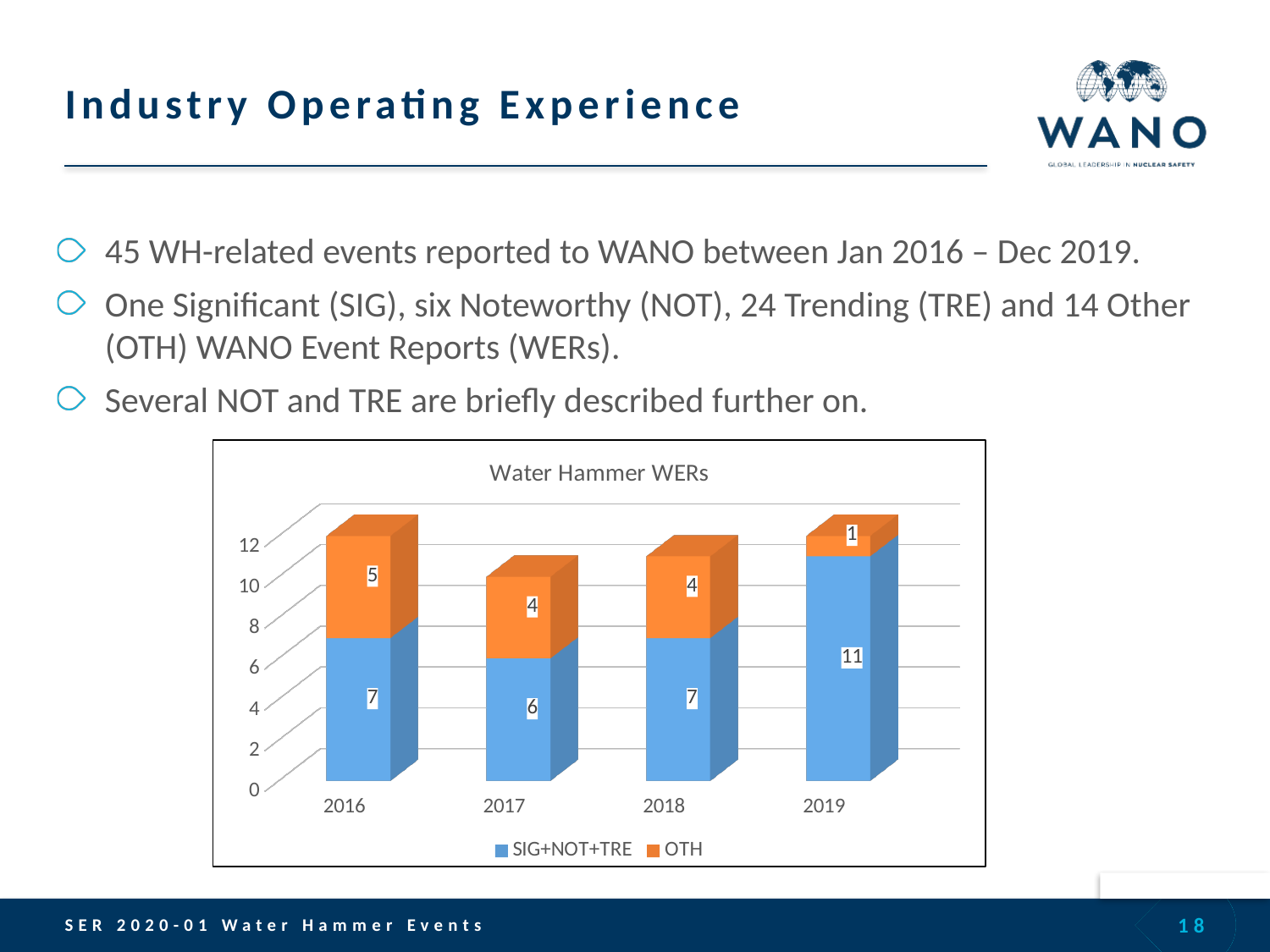
How many years are shown on the x axis? 4 What is the OTH value for 2019? 1 What is the SIG+NOT+TRE value for 2017? 6 Which year has the highest SIG+NOT+TRE value? 2019 How many series does the legend list? 2 Is the OTH value larger for 2016 or 2018? 2016 What is the OTH value for 2016? 5 What is the SIG+NOT+TRE value for 2019? 11 What is the total of the stacked bar for 2016? 12 What is the difference between the SIG+NOT+TRE values for 2019 and 2017? 5 What is the total of the stacked bar for 2017? 10 Which year has the lowest OTH value? 2019